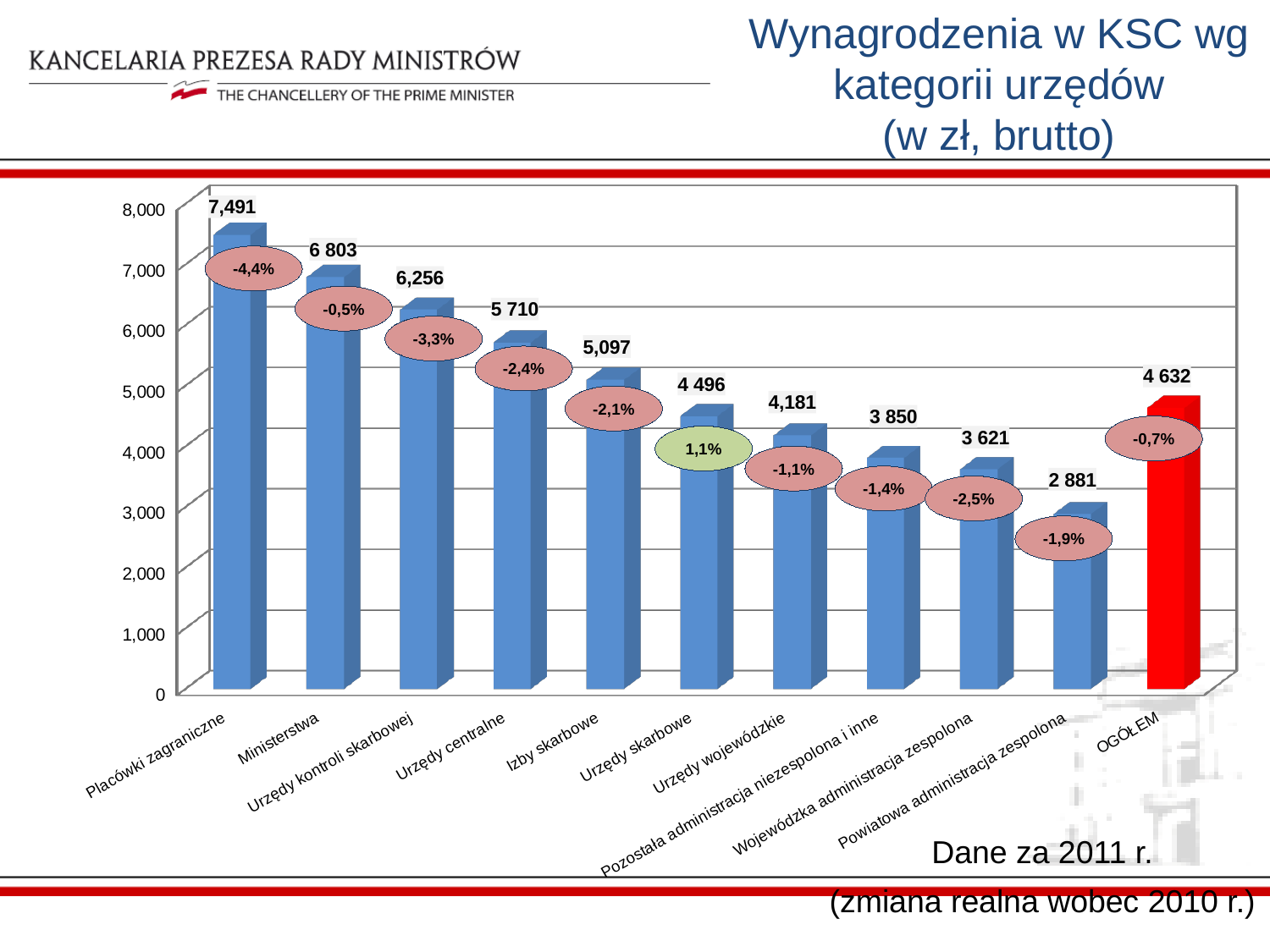
Which category has the lowest value? Powiatowa administracja zespolona What percentage change is shown for Urzędy skarbowe? 1,1% Which bar is coloured red? OGÓŁEM How many categories are shown on the x axis? 11 What is the value for Placówki zagraniczne? 7,491 What kind of chart is shown on the slide? bar chart Which category has the highest value? Placówki zagraniczne Which is larger, the value for Urzędy centralne or the value for Izby skarbowe? Urzędy centralne What is the value for Ministerstwa? 6 803 What is the difference between Pozostała administracja niezespolona i inne and Wojewódzka administracja zespolona? 229 What is the value for Powiatowa administracja zespolona? 2 881 What is the value for OGÓŁEM? 4 632